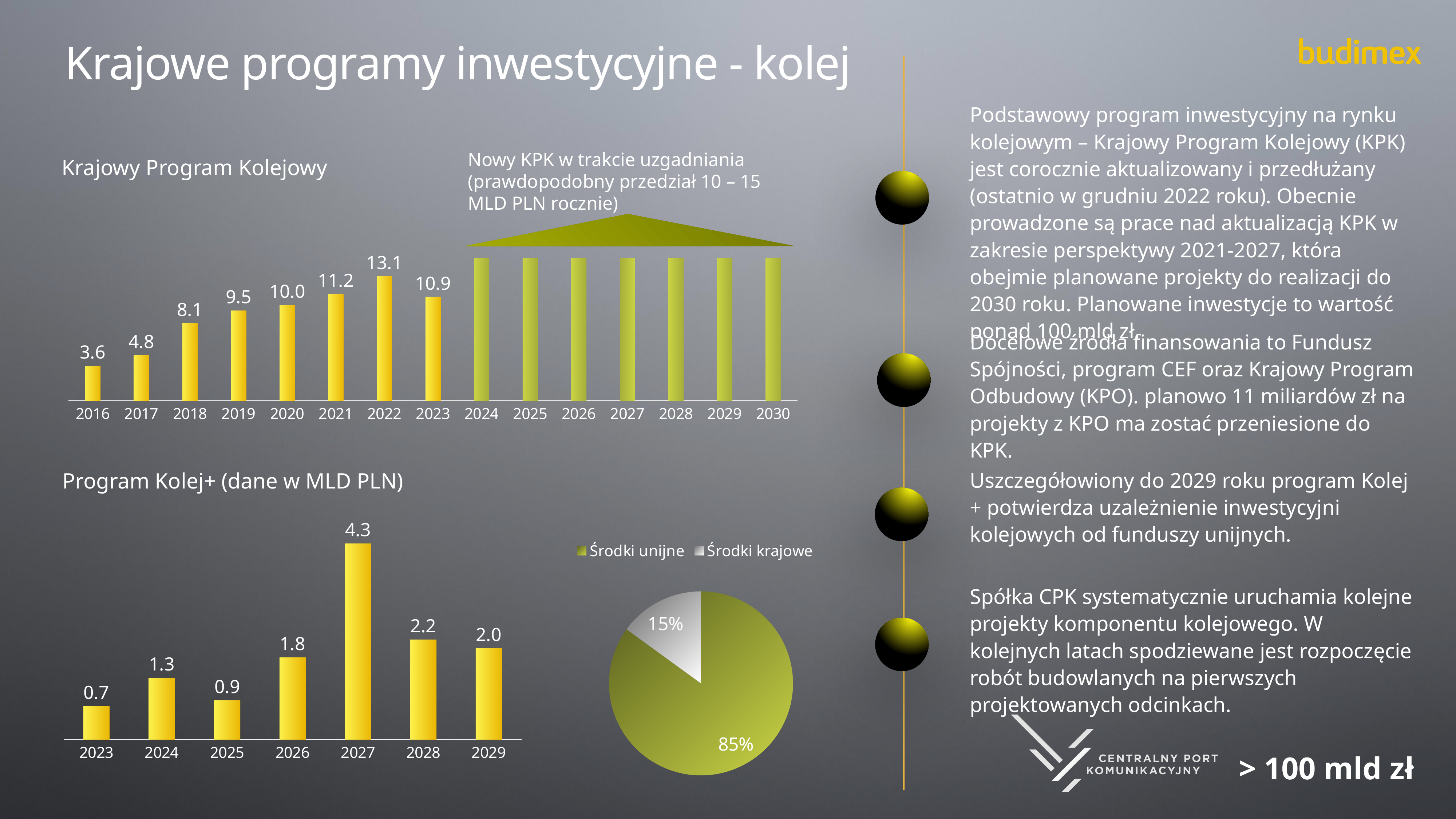
In the "Krajowy Program Kolejowy" chart, what is the value for 2022? 13.1 In the "Krajowy Program Kolejowy" chart, what is the difference between the values for 2022 and 2023? 2.2 In the pie chart, what share does "Środki unijne" have? 85% In the "Program Kolej+ (dane w MLD PLN)" chart, which year has the lowest value? 2023 In the "Program Kolej+ (dane w MLD PLN)" chart, what is the difference between the values for 2028 and 2029? 0.2 In the "Krajowy Program Kolejowy" chart, what is the value for 2016? 3.6 In the "Krajowy Program Kolejowy" chart, which year among the labelled bars has the highest value? 2022 What kind of chart is "Program Kolej+ (dane w MLD PLN)"? Bar chart In the "Program Kolej+ (dane w MLD PLN)" chart, how many years are shown on the x axis? 7 In the "Krajowy Program Kolejowy" chart, which is larger, the value for 2019 or the value for 2020? 2020 How many series does the legend of the pie chart list? 2 In the "Program Kolej+ (dane w MLD PLN)" chart, what is the value for 2027? 4.3